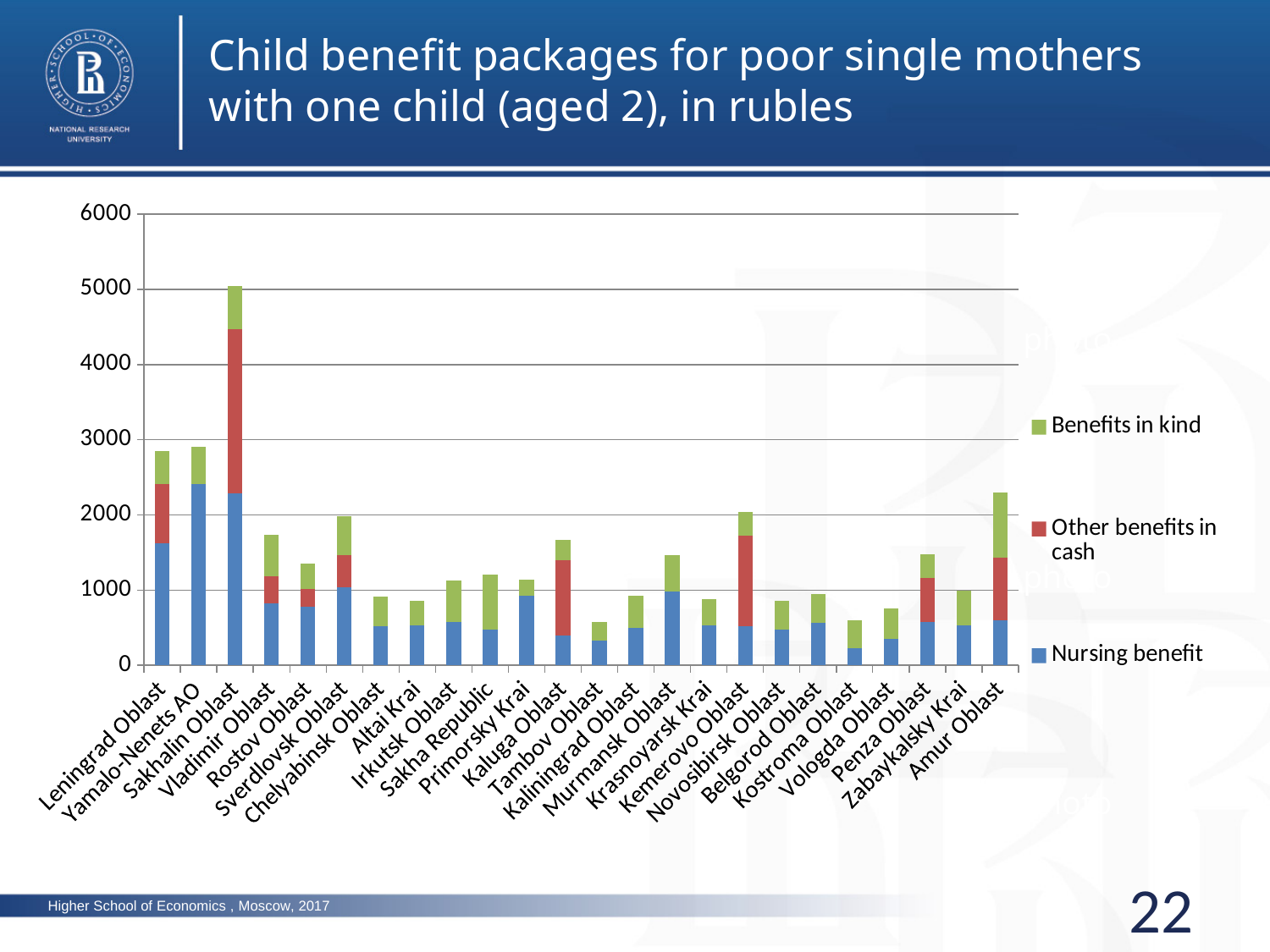
How many series does the legend list? 3 Is the total value for Sakhalin Oblast greater or less than 4000? greater What kind of chart is shown on the slide? Stacked bar chart Which region has the highest total child benefit package? Sakhalin Oblast How many regions are shown on the x axis of the chart? 24 Is the total value for Yamalo-Nenets AO greater or less than 2000? greater Which series is shown in green in the chart? Benefits in kind Is the total value for Amur Oblast greater or less than 2000? greater Which has the larger total benefit package, Kemerovo Oblast or Altai Krai? Kemerovo Oblast Which has the larger total benefit package, Sakhalin Oblast or Leningrad Oblast? Sakhalin Oblast